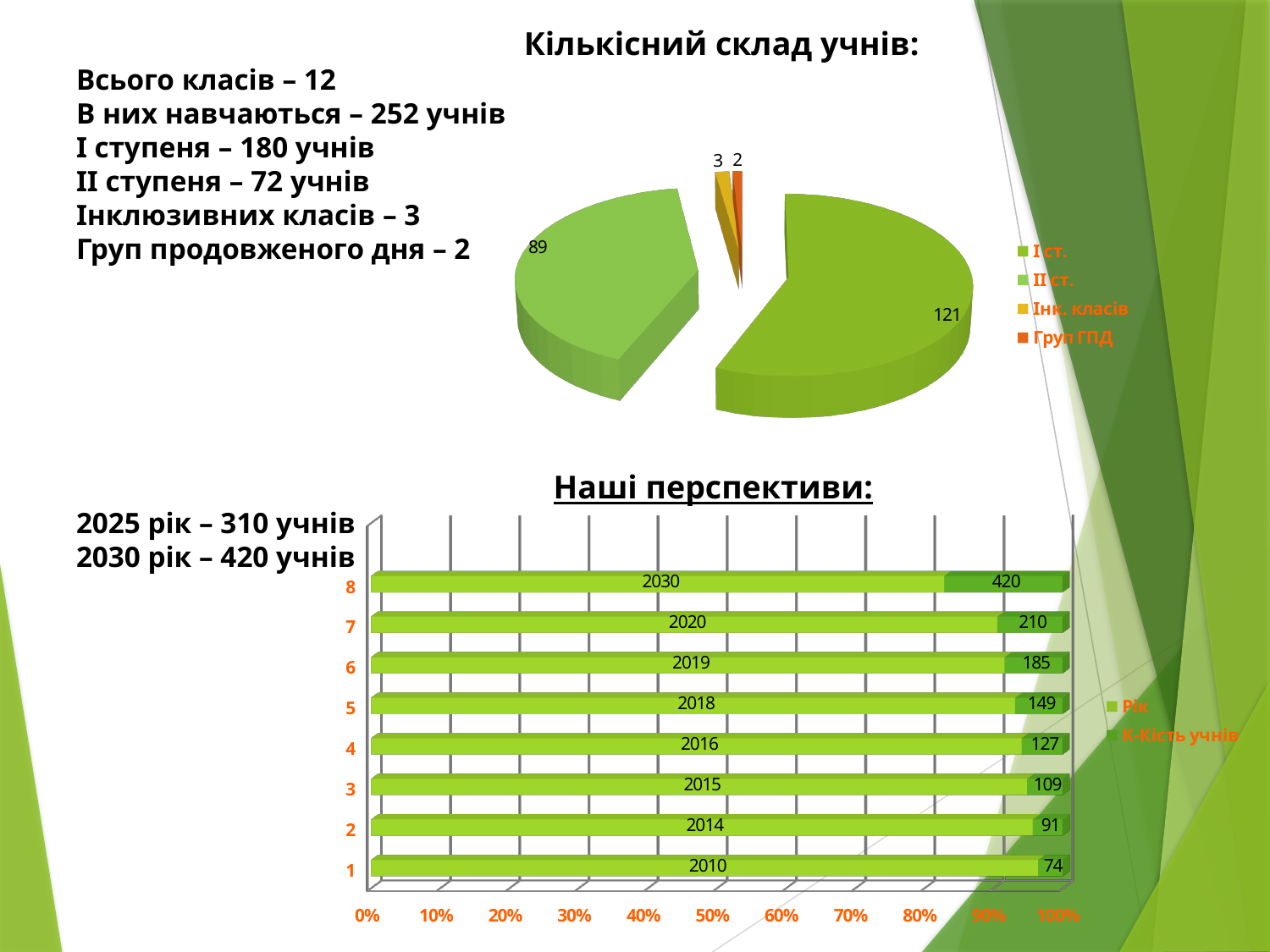
What type of chart is the lower chart titled "Наші перспективи:"? Bar chart In the pie chart titled "Кількісний склад учнів:", what is the value of the "II ст." slice? 89 In the bar chart titled "Наші перспективи:", what is the difference between the "К-кість учнів" values for 2020 and 2019? 25 How many entries does the legend of the pie chart titled "Кількісний склад учнів:" list? 4 In the pie chart titled "Кількісний склад учнів:", which category has the smallest slice? Груп ГПД In the pie chart titled "Кількісний склад учнів:", which category has the largest slice? I ст. In the bar chart titled "Наші перспективи:", what year label is shown for category 1? 2010 In the pie chart titled "Кількісний склад учнів:", what is the difference between the "I ст." and "II ст." values? 32 In the bar chart titled "Наші перспективи:", what is the "К-кість учнів" value for category 8? 420 In the bar chart titled "Наші перспективи:", how many categories are shown on the vertical axis? 8 What type of chart is the upper chart titled "Кількісний склад учнів:"? Pie chart In the pie chart titled "Кількісний склад учнів:", what is the value of the "I ст." slice? 121